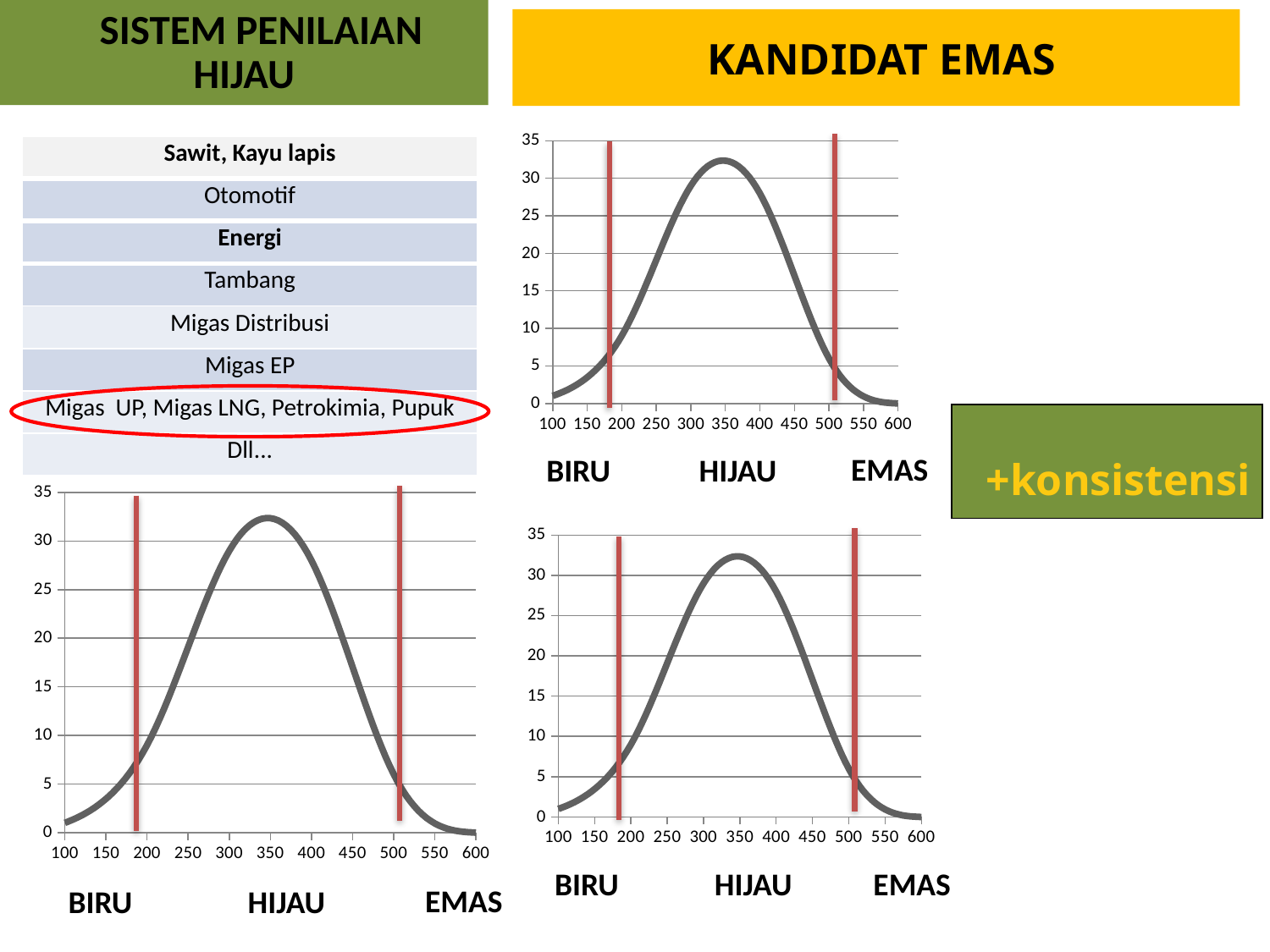
On the bottom-left chart, how many tick labels are shown on the x axis? 11 On the top-right chart, does the curve rise or fall between x = 100 and x = 350? rise On the bottom-left chart, is the value of the curve at x = 350 greater or less than 25? greater On the bottom-right chart, is the value of the curve at x = 100 greater or less than 5? less What kind of chart is the bottom-left chart on the slide? line chart How many charts are shown on the slide? 3 On the bottom-right chart, does the curve rise or fall between x = 350 and x = 600? fall On the top-right chart, what is the highest value labelled on the y axis? 35 On the bottom-left chart, is the peak of the curve greater or less than 30? greater What kind of chart is the top-right chart under the heading KANDIDAT EMAS? line chart What three labels appear below the x axis of the bottom-left chart, from left to right? BIRU, HIJAU, EMAS